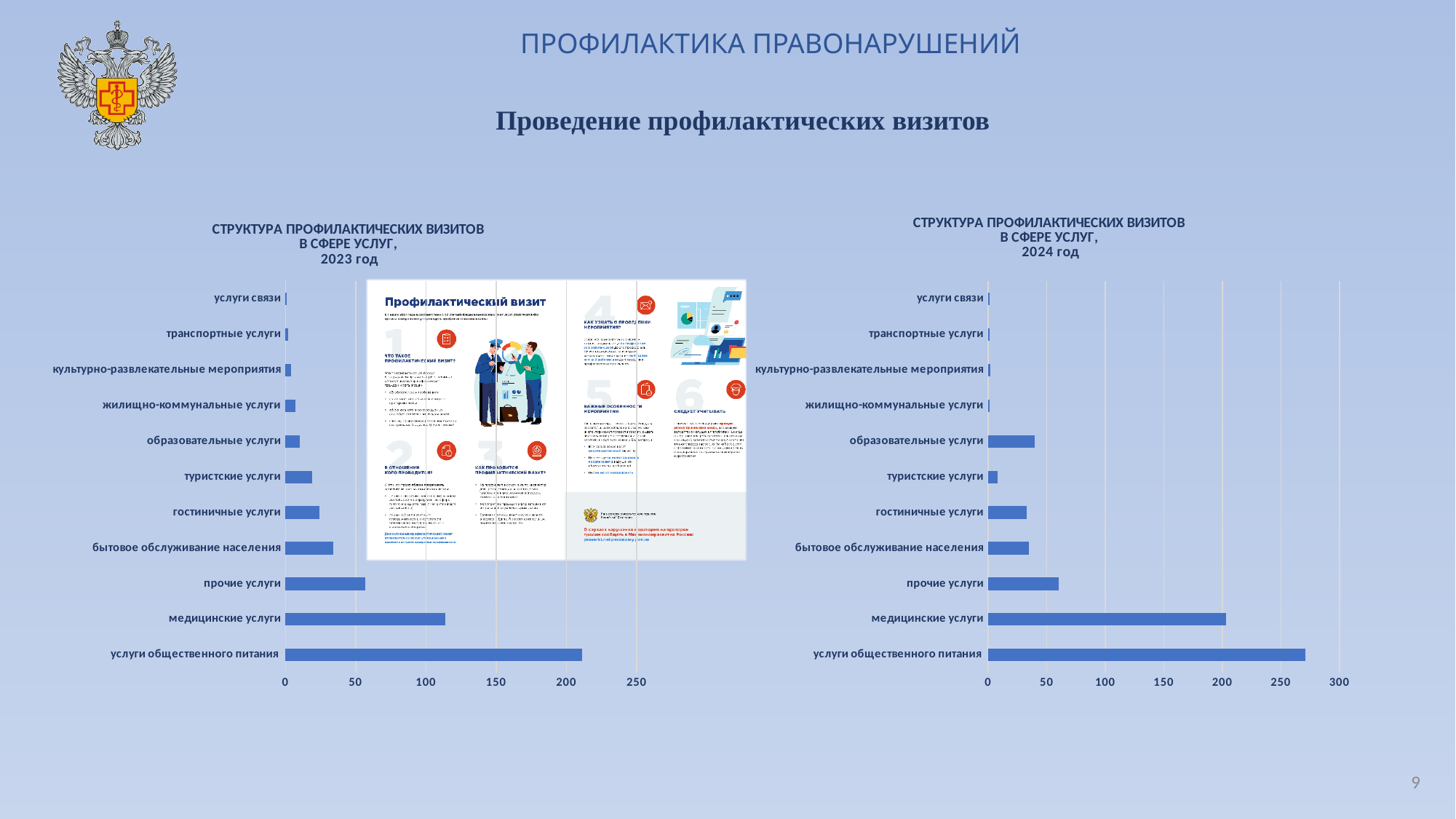
In the 2024 chart on the right, which category has the highest value? услуги общественного питания In the 2023 chart on the left, which is larger: медицинские услуги or прочие услуги? медицинские услуги What is the highest tick value on the x axis of the 2024 chart on the right? 300 In the 2023 chart on the left, is the value for медицинские услуги greater or less than 100? greater How many categories are shown in the 2023 chart on the left? 11 In the 2024 chart on the right, which is larger: гостиничные услуги or туристские услуги? гостиничные услуги In the 2024 chart on the right, is the value for образовательные услуги greater or less than 50? less In the 2023 chart on the left, which category has the highest value? услуги общественного питания What kind of chart is the left chart titled 'СТРУКТУРА ПРОФИЛАКТИЧЕСКИХ ВИЗИТОВ В СФЕРЕ УСЛУГ, 2023 год'? bar chart How many categories are shown in the 2024 chart on the right? 11 In the 2024 chart on the right, is the value for услуги общественного питания greater or less than 250? greater